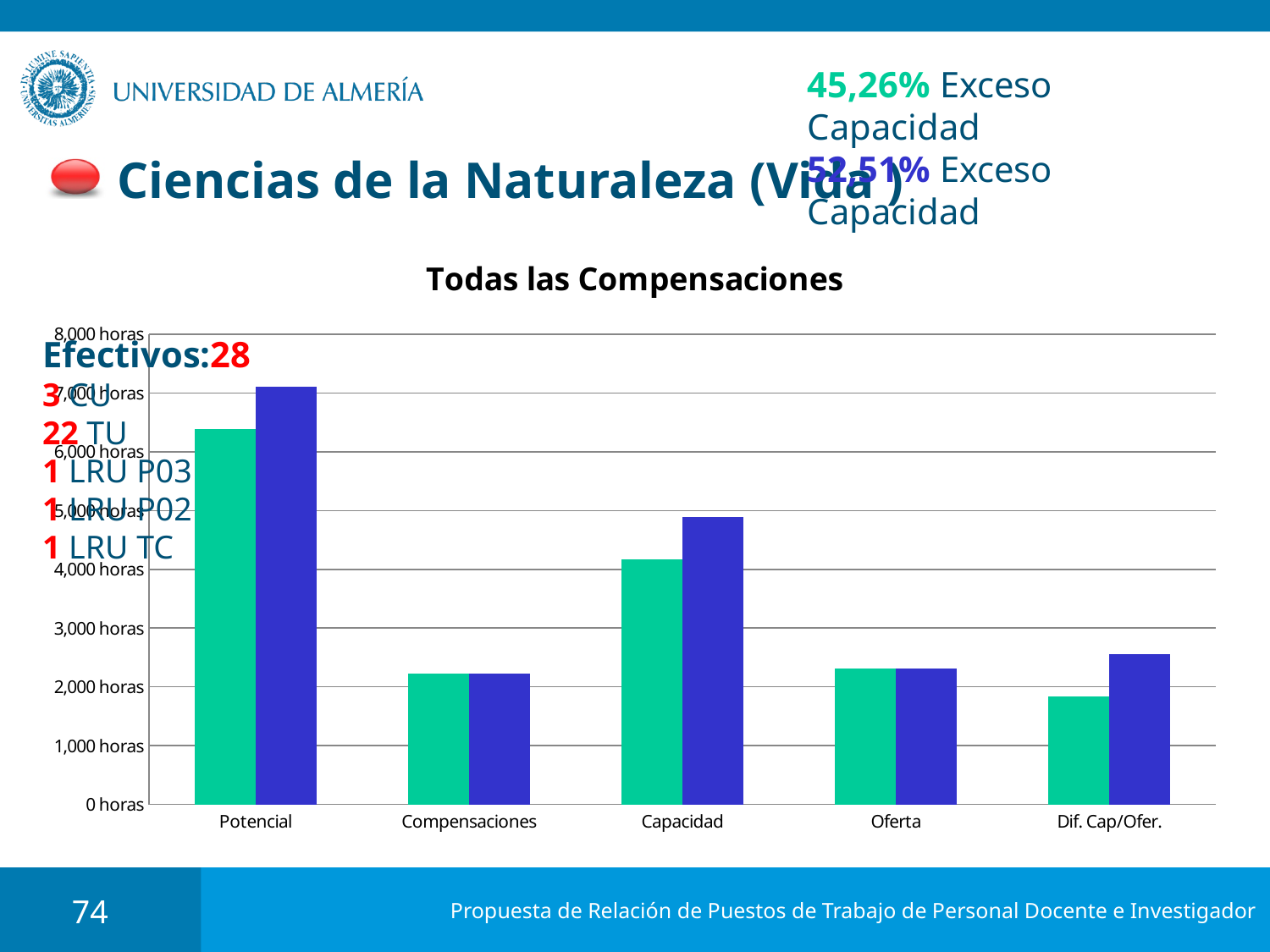
Which green bar is taller, Capacidad or Oferta? Capacidad For the Potencial category, which bar is taller, the green one or the blue one? the blue one Which category has the highest blue bar in the chart? Potencial Is the blue bar for Dif. Cap/Ofer. greater or less than 2,000 horas? greater What kind of chart is shown on the slide? bar chart Is the green bar for Potencial greater or less than 6,000 horas? greater How many categories are shown on the x axis of the chart? 5 Which category has the lowest green bar in the chart? Dif. Cap/Ofer. What is the title of the chart? Todas las Compensaciones Is the green bar for Capacidad greater or less than 4,000 horas? greater Which category has the highest green bar in the chart? Potencial